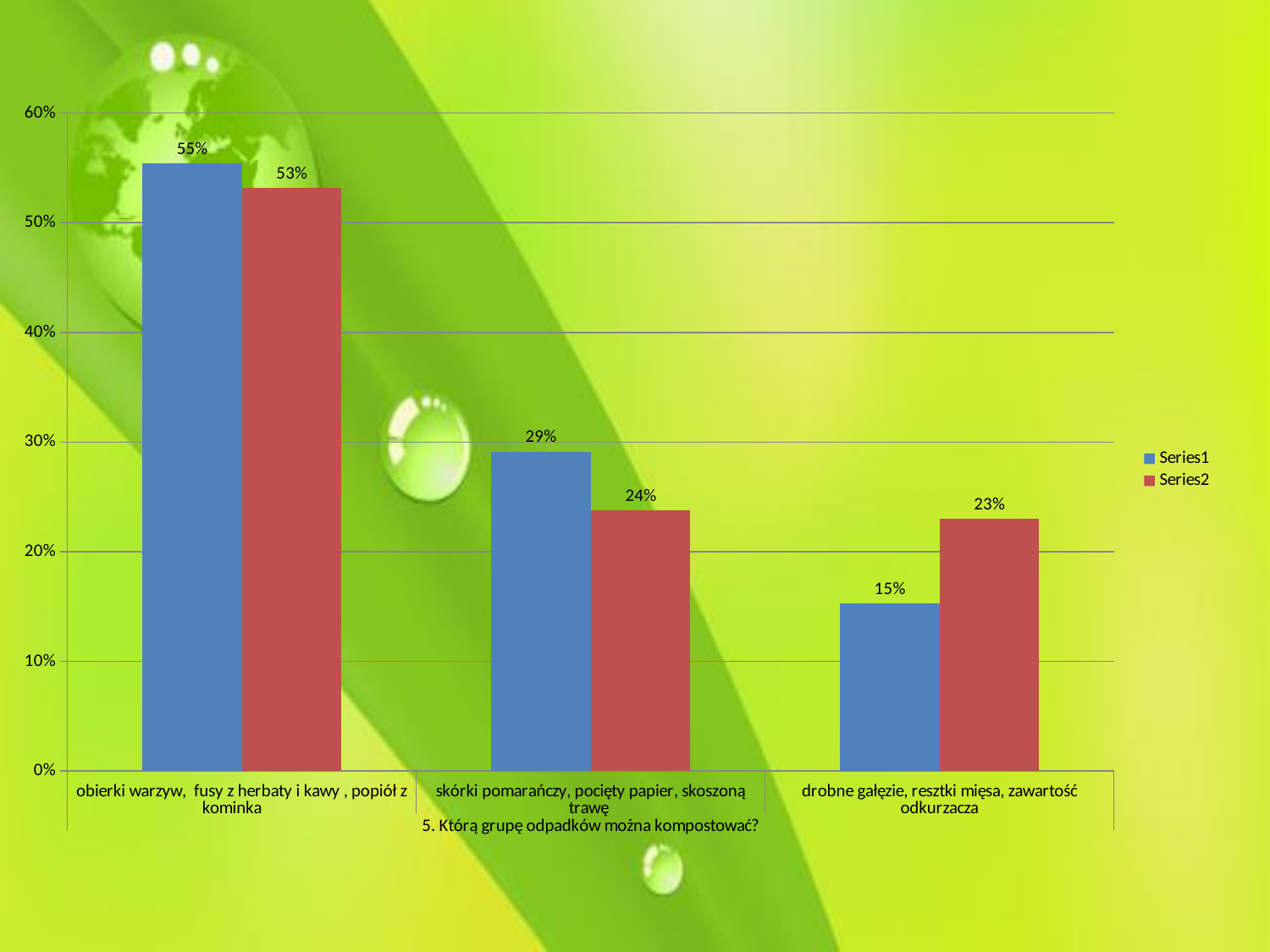
What is the Series1 value for "drobne gałęzie, resztki mięsa, zawartość odkurzacza"? 15% What is the Series1 value for "obierki warzyw, fusy z herbaty i kawy, popiół z kominka"? 55% What is the difference between the Series1 and Series2 values for "skórki pomarańczy, pocięty papier, skoszoną trawę"? 5% For "drobne gałęzie, resztki mięsa, zawartość odkurzacza", which series has the larger value, Series1 or Series2? Series2 Is the Series2 value for "obierki warzyw, fusy z herbaty i kawy, popiół z kominka" greater or less than 50%? greater Which category has the highest Series2 value? obierki warzyw, fusy z herbaty i kawy, popiół z kominka Which category has the lowest Series1 value? drobne gałęzie, resztki mięsa, zawartość odkurzacza How many categories are shown on the x axis? 3 What is the Series2 value for "skórki pomarańczy, pocięty papier, skoszoną trawę"? 24% How many series does the legend list? 2 What kind of chart is shown on the slide? bar chart What is the x-axis title of the chart? 5. Którą grupę odpadków można kompostować?